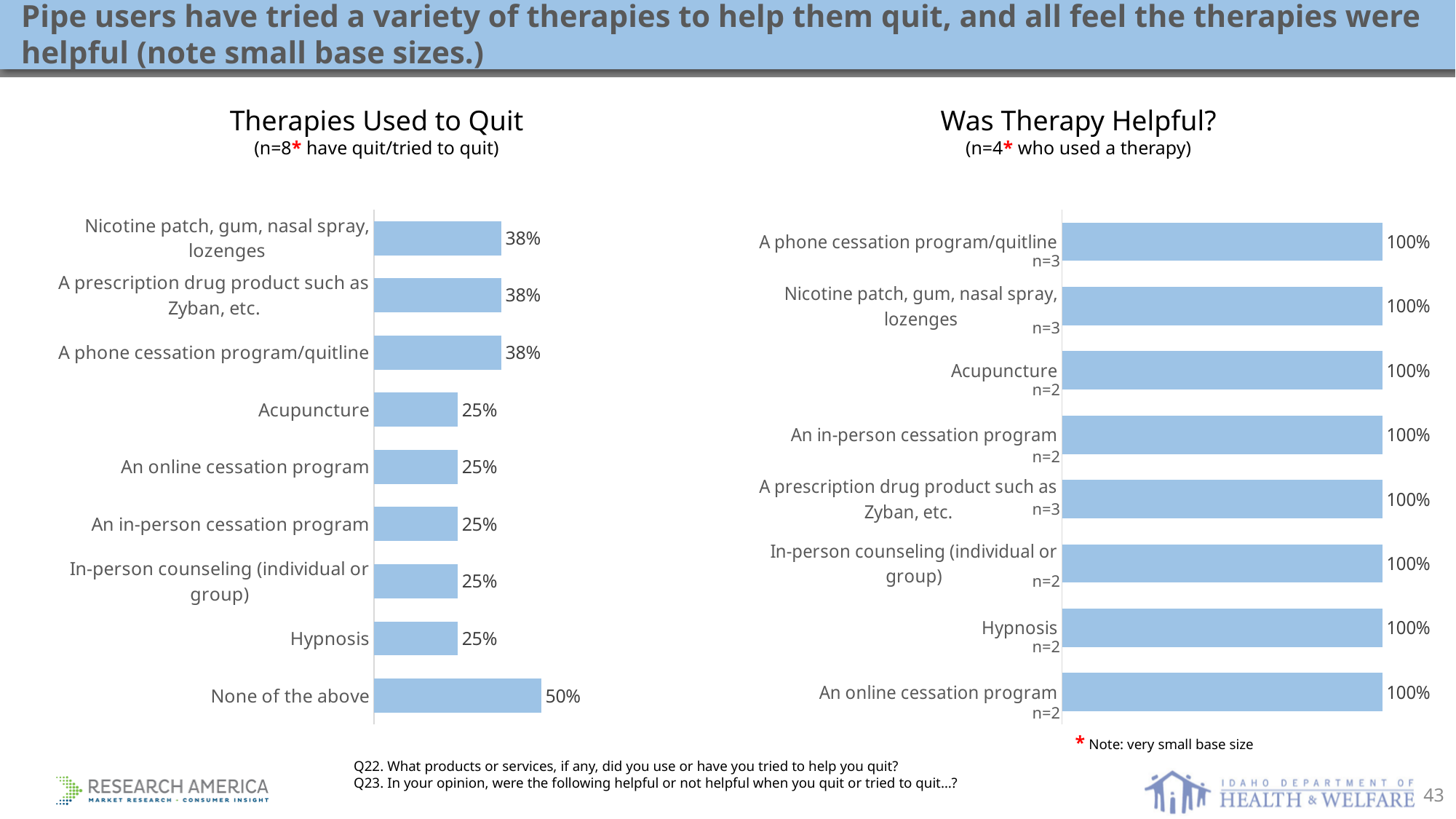
What is the subtitle shown under the 'Therapies Used to Quit' chart title? (n=8* have quit/tried to quit) In the 'Therapies Used to Quit' chart, what is the difference between 'None of the above' and Hypnosis? 25% How many categories are shown in the 'Therapies Used to Quit' chart? 9 How many categories are shown in the 'Was Therapy Helpful?' chart? 8 In the 'Was Therapy Helpful?' chart, what percentage is shown for Hypnosis? 100% In the 'Was Therapy Helpful?' chart, what is the base size (n) shown for Acupuncture? n=2 In the 'Therapies Used to Quit' chart, which is larger: 'A prescription drug product such as Zyban, etc.' or 'An online cessation program'? A prescription drug product such as Zyban, etc. In the 'Therapies Used to Quit' chart, what percentage is shown for 'A phone cessation program/quitline'? 38% What type of chart is the 'Was Therapy Helpful?' chart? Bar chart In the 'Therapies Used to Quit' chart, which category has the highest value? None of the above In the 'Therapies Used to Quit' chart, what percentage is shown for 'None of the above'? 50% In the 'Therapies Used to Quit' chart, what percentage is shown for Acupuncture? 25%